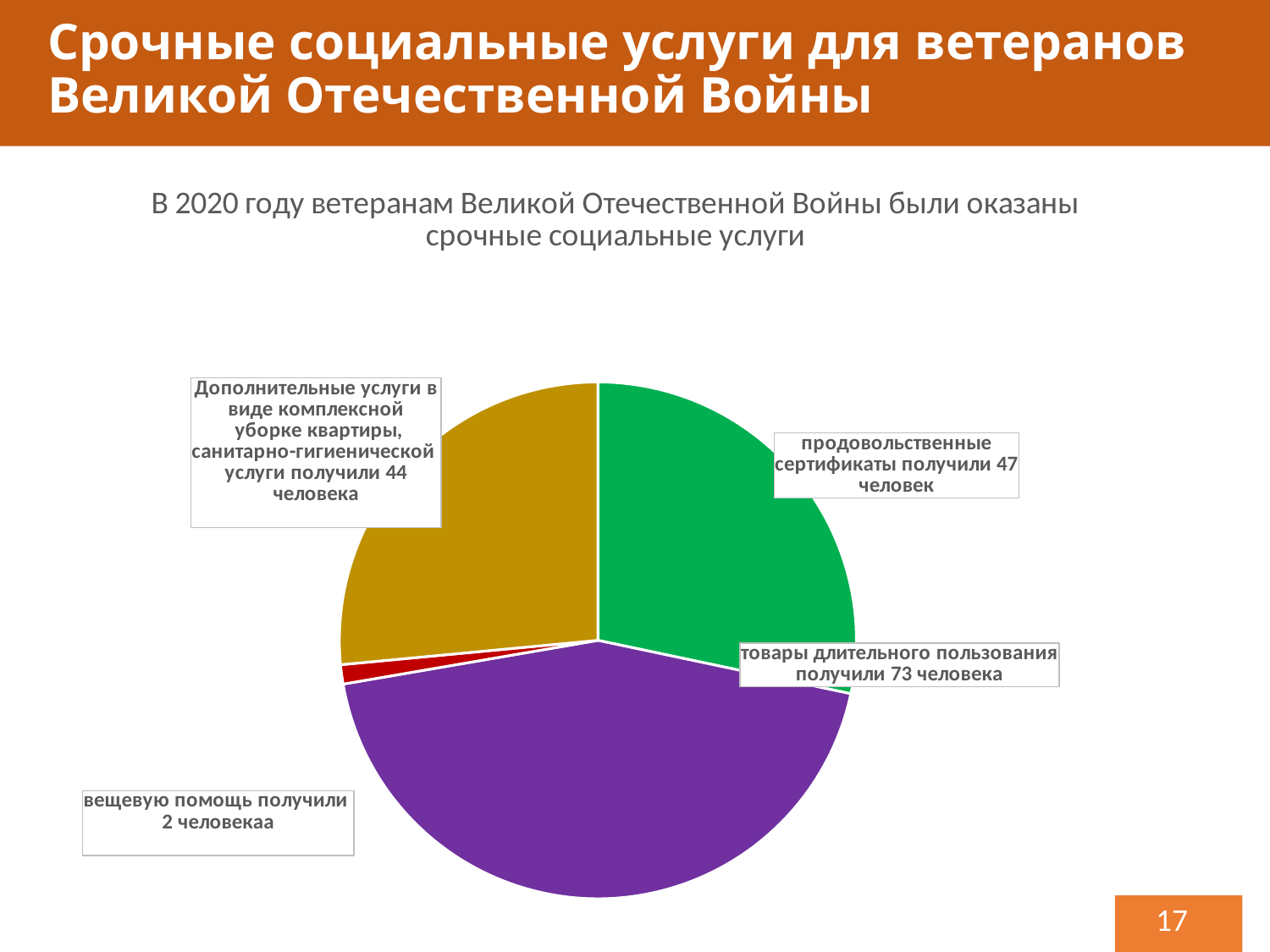
How many people received clothing assistance (вещевую помощь) according to the pie chart? 2 Which category in the pie chart has the largest number of recipients? товары длительного пользования How many more people received durable goods than food certificates? 26 Which category in the pie chart has the smallest number of recipients? вещевую помощь How many people received additional services such as comprehensive apartment cleaning and sanitary-hygienic services? 44 человека How many people received durable goods (товары длительного пользования) according to the pie chart? 73 человека What colour is the slice representing durable goods (товары длительного пользования)? purple How many categories of urgent social services are shown in the pie chart? 4 What type of chart is shown on the slide? pie chart Which had more recipients: food certificates or additional cleaning and sanitary-hygienic services? продовольственные сертификаты How many people received food certificates (продовольственные сертификаты) according to the pie chart? 47 человек What is the difference between the number of people who received food certificates and those who received additional cleaning and sanitary-hygienic services? 3